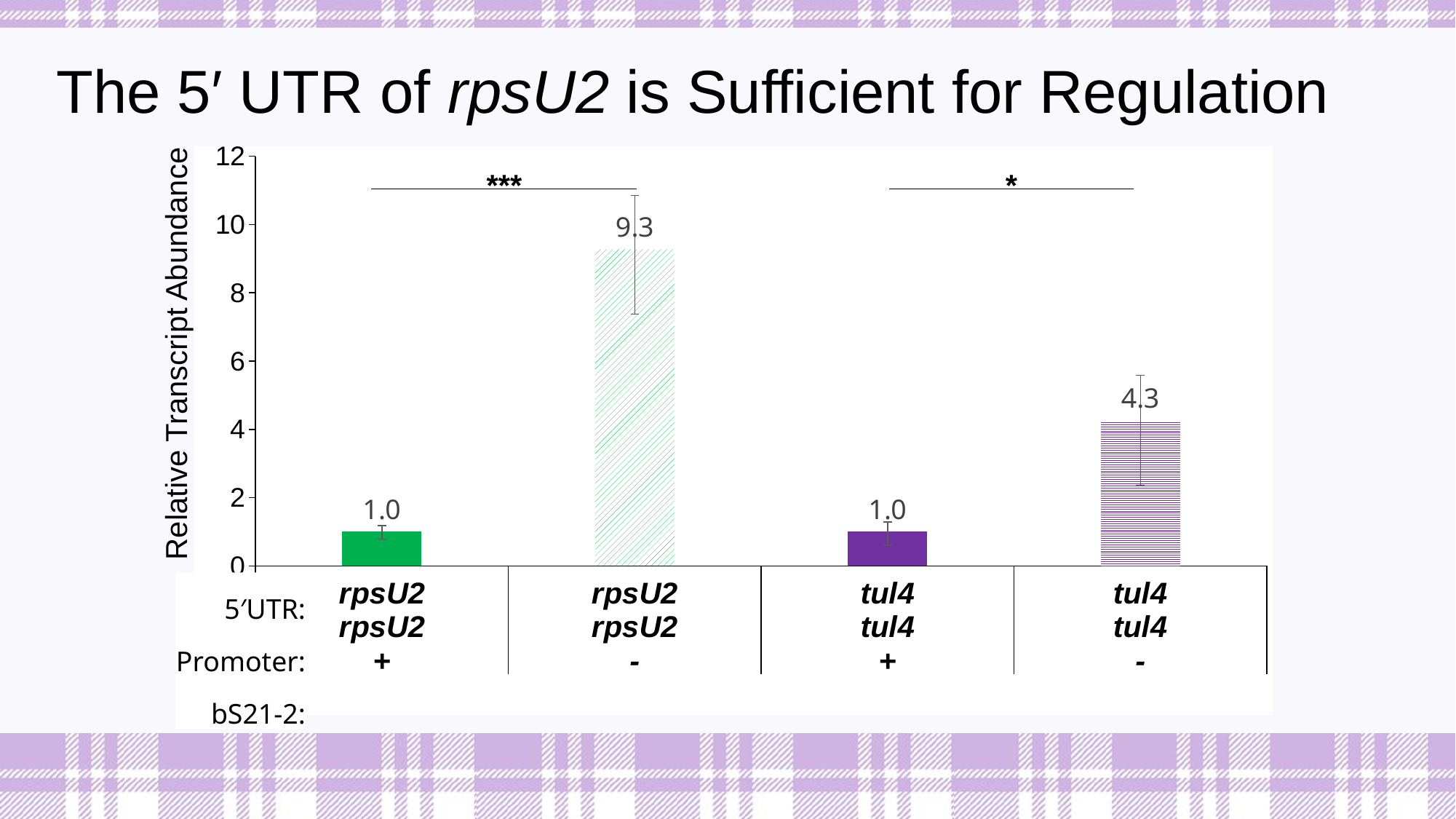
What is the relative transcript abundance for the rpsU2 5′UTR construct with bS21-2 absent (-)? 9.3 What is the label of the y axis? Relative Transcript Abundance What is the maximum value shown on the y axis? 12 What is the relative transcript abundance for the rpsU2 5′UTR construct with bS21-2 present (+)? 1.0 What kind of chart is shown on the slide? bar chart Which bar has the highest relative transcript abundance? rpsU2 5′UTR, bS21-2 - Is the value for the tul4 bS21-2 - bar greater or less than 6? less Which is larger: the relative transcript abundance for rpsU2 with bS21-2 - or for tul4 with bS21-2 -? rpsU2 with bS21-2 - What is the difference in relative transcript abundance between the rpsU2 bS21-2 - bar and the rpsU2 bS21-2 + bar? 8.3 What is the relative transcript abundance for the tul4 5′UTR construct with bS21-2 absent (-)? 4.3 How many bars are plotted in the chart? 4 What is the difference in relative transcript abundance between the rpsU2 bS21-2 - bar and the tul4 bS21-2 - bar? 5.0